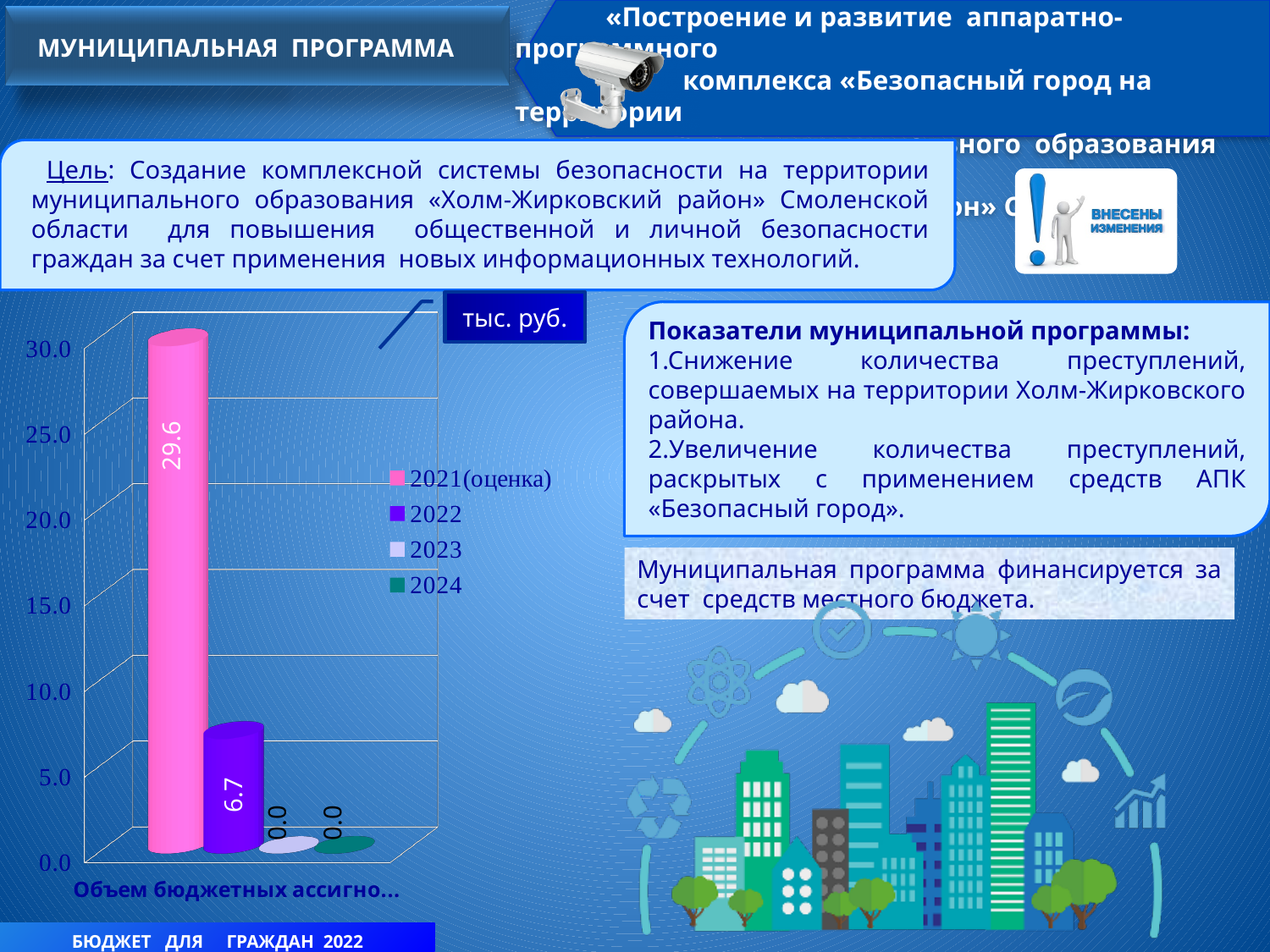
Which is larger, the value for 2021(оценка) or the value for 2022? 2021(оценка) How many series does the chart legend list? 4 What is the value for 2023 in the chart? 0.0 Which series has the highest value in the chart? 2021(оценка) What is the value for 2021(оценка) in the chart? 29.6 Is the value for 2022 greater or less than 10.0? less What is the difference between the values for 2021(оценка) and 2022? 22.9 What is the value for 2024 in the chart? 0.0 What is the value for 2022 in the chart? 6.7 Is the value for 2021(оценка) greater or less than 25.0? greater What unit is shown in the box above the chart? тыс. руб. What kind of chart is shown on the slide? bar chart